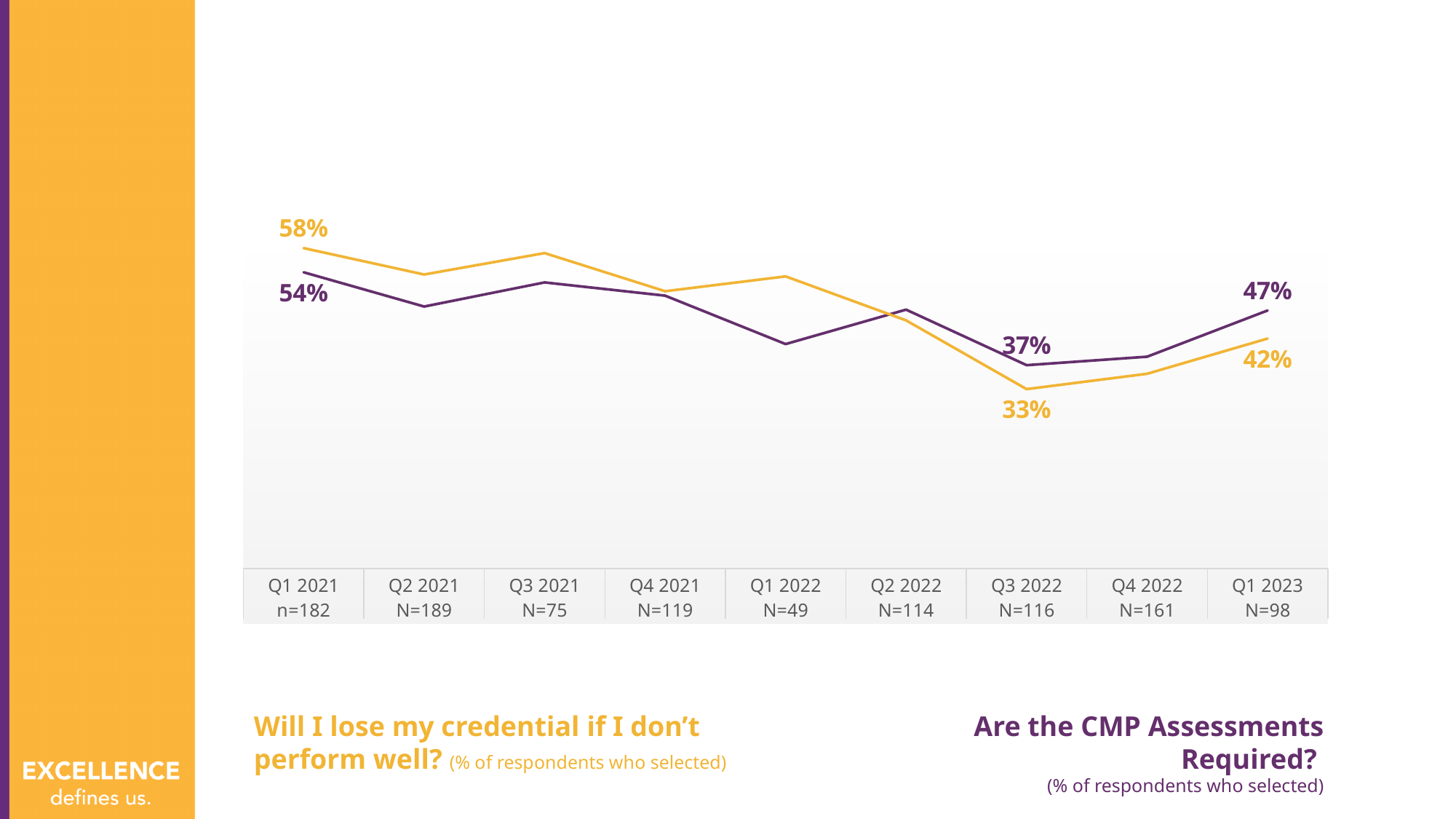
What kind of chart is shown on the slide? Line chart What percentage of respondents selected "Will I lose my credential if I don't perform well?" in Q3 2022? 33% In Q1 2021, which series has the higher value: "Will I lose my credential if I don't perform well?" or "Are the CMP Assessments Required?"? Will I lose my credential if I don't perform well? What percentage of respondents selected "Are the CMP Assessments Required?" in Q1 2023? 47% What is the sample size (N) shown for Q1 2022? N=49 What percentage of respondents selected "Are the CMP Assessments Required?" in Q1 2021? 54% Does the "Are the CMP Assessments Required?" series rise or fall from Q1 2021 to Q3 2022? Fall How many quarters are plotted along the x axis? 9 What percentage of respondents selected "Will I lose my credential if I don't perform well?" in Q1 2021? 58% What is the difference between the Q1 2021 and Q3 2022 values for "Will I lose my credential if I don't perform well?"? 25% In Q1 2023, which series has the higher value: "Will I lose my credential if I don't perform well?" or "Are the CMP Assessments Required?"? Are the CMP Assessments Required? How many series does the chart plot? 2